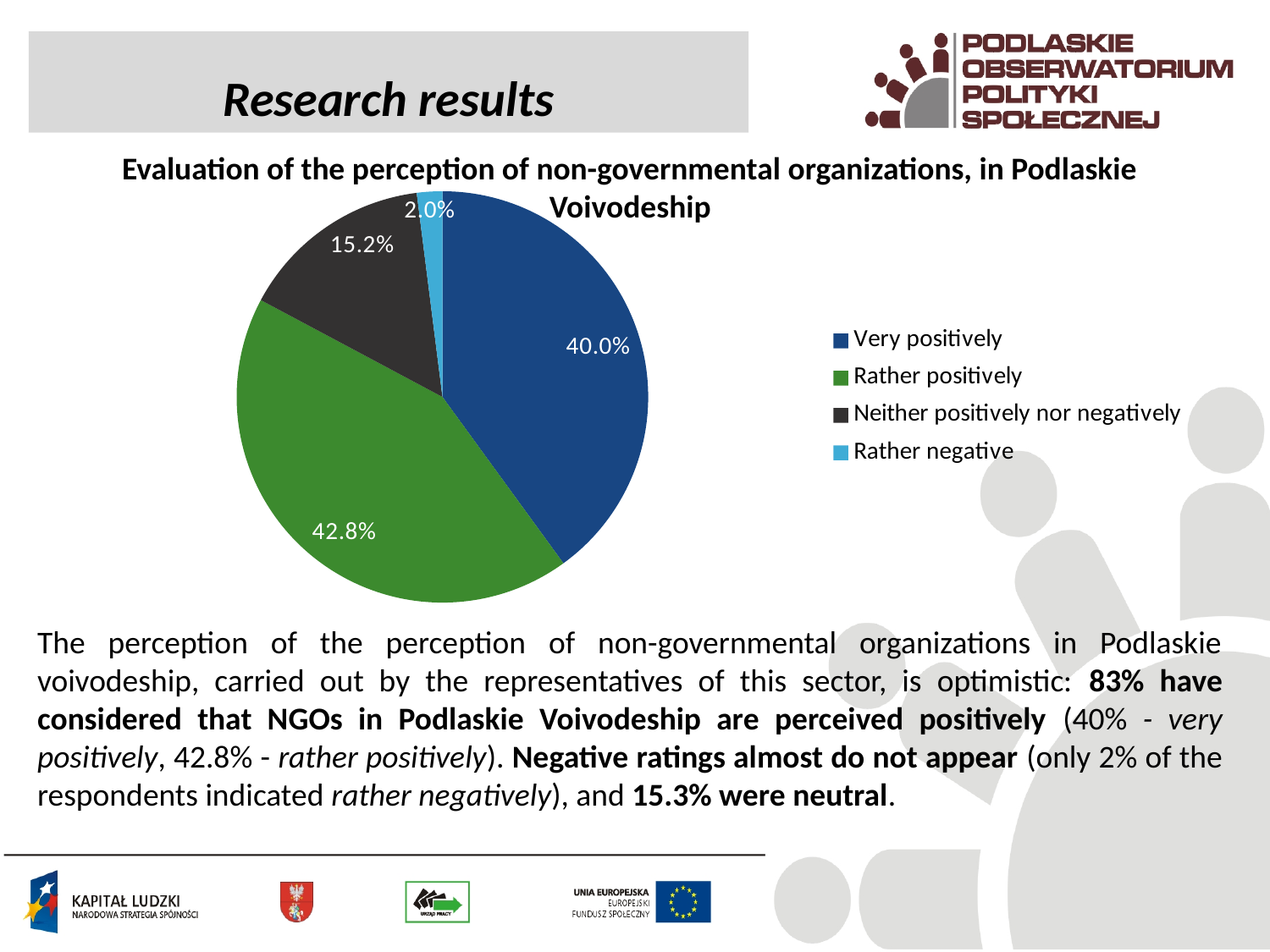
What share of the pie is labelled 'Rather positively'? 42.8% Which category has the smallest slice of the pie? Rather negative What type of chart is shown on the slide? pie chart What share of the pie is labelled 'Very positively'? 40.0% Which category has the largest slice of the pie? Rather positively Which is larger: the 'Neither positively nor negatively' slice or the 'Rather negative' slice? Neither positively nor negatively What share of the pie is labelled 'Rather negative'? 2.0% What is the difference between the 'Rather positively' and 'Very positively' shares? 2.8% What is the title of the chart? Evaluation of the perception of non-governmental organizations, in Podlaskie Voivodeship What colour is the 'Rather positively' slice? green How many categories does the pie chart show? 4